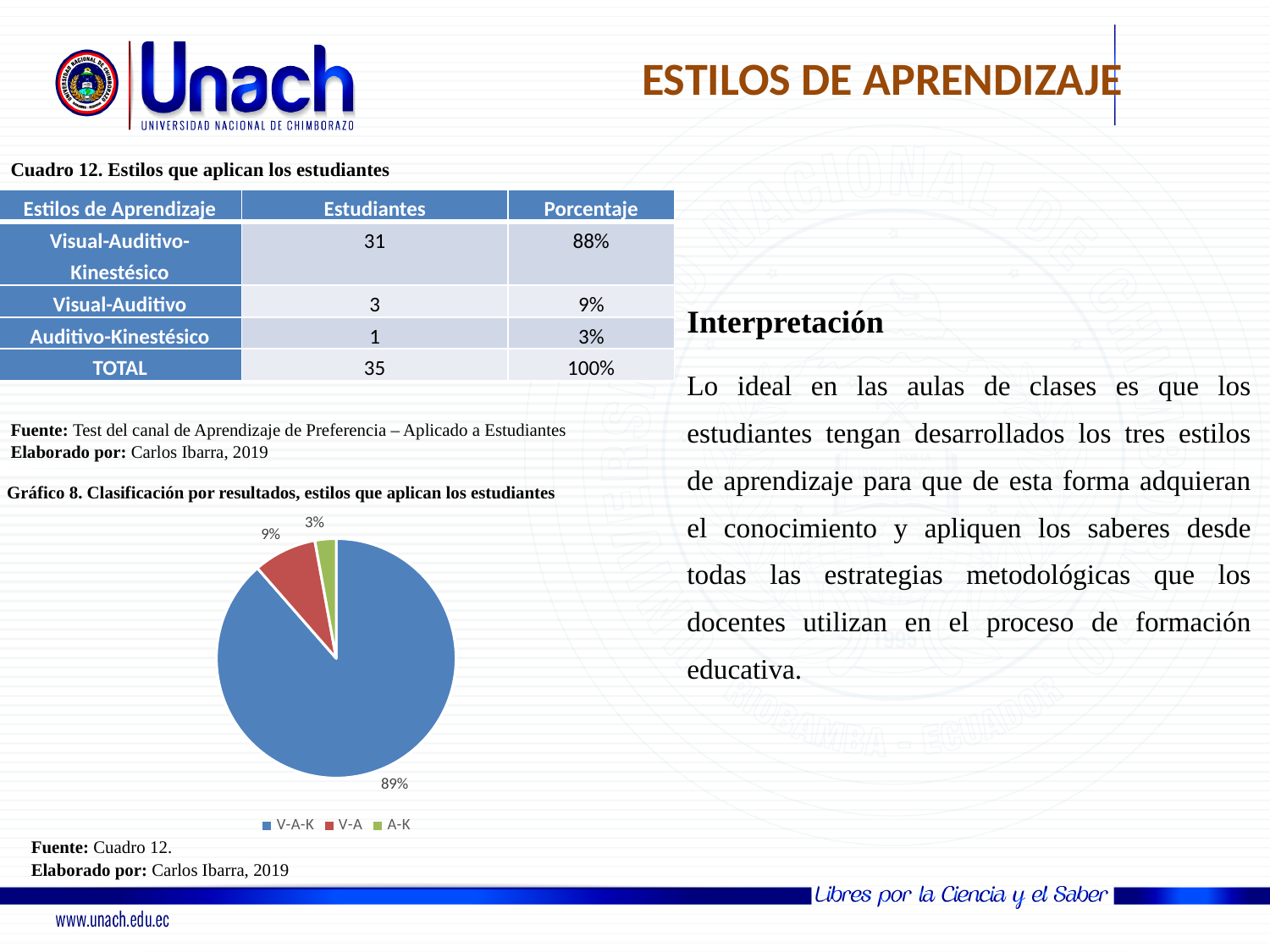
What kind of chart is shown in Gráfico 8? pie chart What is the difference in percentage points between the V-A-K slice and the V-A slice in the pie chart? 80 In the pie chart, what percentage is shown for V-A? 9% In the pie chart, what percentage is shown for V-A-K? 89% In the pie chart, which is larger, the V-A slice or the A-K slice? V-A Which category has the largest slice in the pie chart? V-A-K How many entries does the pie chart legend list? 3 What is the title of the chart (Gráfico 8)? Clasificación por resultados, estilos que aplican los estudiantes Which category has the smallest slice in the pie chart? A-K What colour is the V-A-K slice in the pie chart? blue In the pie chart, what percentage is shown for A-K? 3% How many slices does the pie chart have? 3